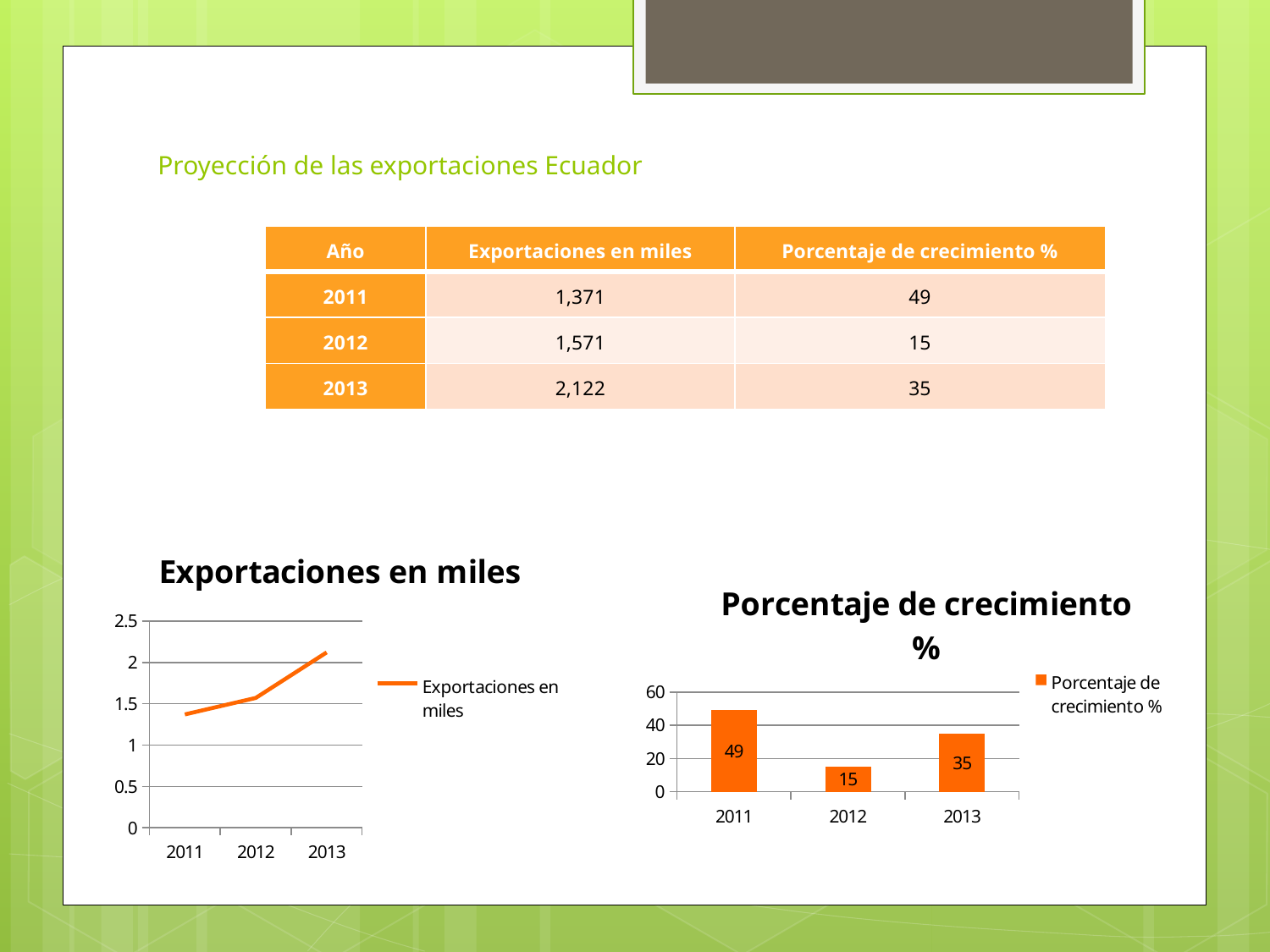
In the 'Porcentaje de crecimiento %' chart, what is the value for 2012? 15 In the 'Porcentaje de crecimiento %' chart, what is the value for 2011? 49 In the 'Porcentaje de crecimiento %' chart, which year has the lowest value? 2012 In the 'Exportaciones en miles' chart, is the value for 2013 greater or less than 2? greater What kind of chart is the 'Porcentaje de crecimiento %' chart? bar chart In the 'Porcentaje de crecimiento %' chart, what is the difference between the values for 2011 and 2012? 34 What kind of chart is the 'Exportaciones en miles' chart? line chart In the 'Exportaciones en miles' chart, do the values rise or fall from 2011 to 2013? rise In the 'Porcentaje de crecimiento %' chart, which is larger, the value for 2013 or the value for 2012? 2013 How many years are shown on the x axis of the 'Exportaciones en miles' chart? 3 In the 'Porcentaje de crecimiento %' chart, which year has the highest value? 2011 In the 'Porcentaje de crecimiento %' chart, what is the value for 2013? 35